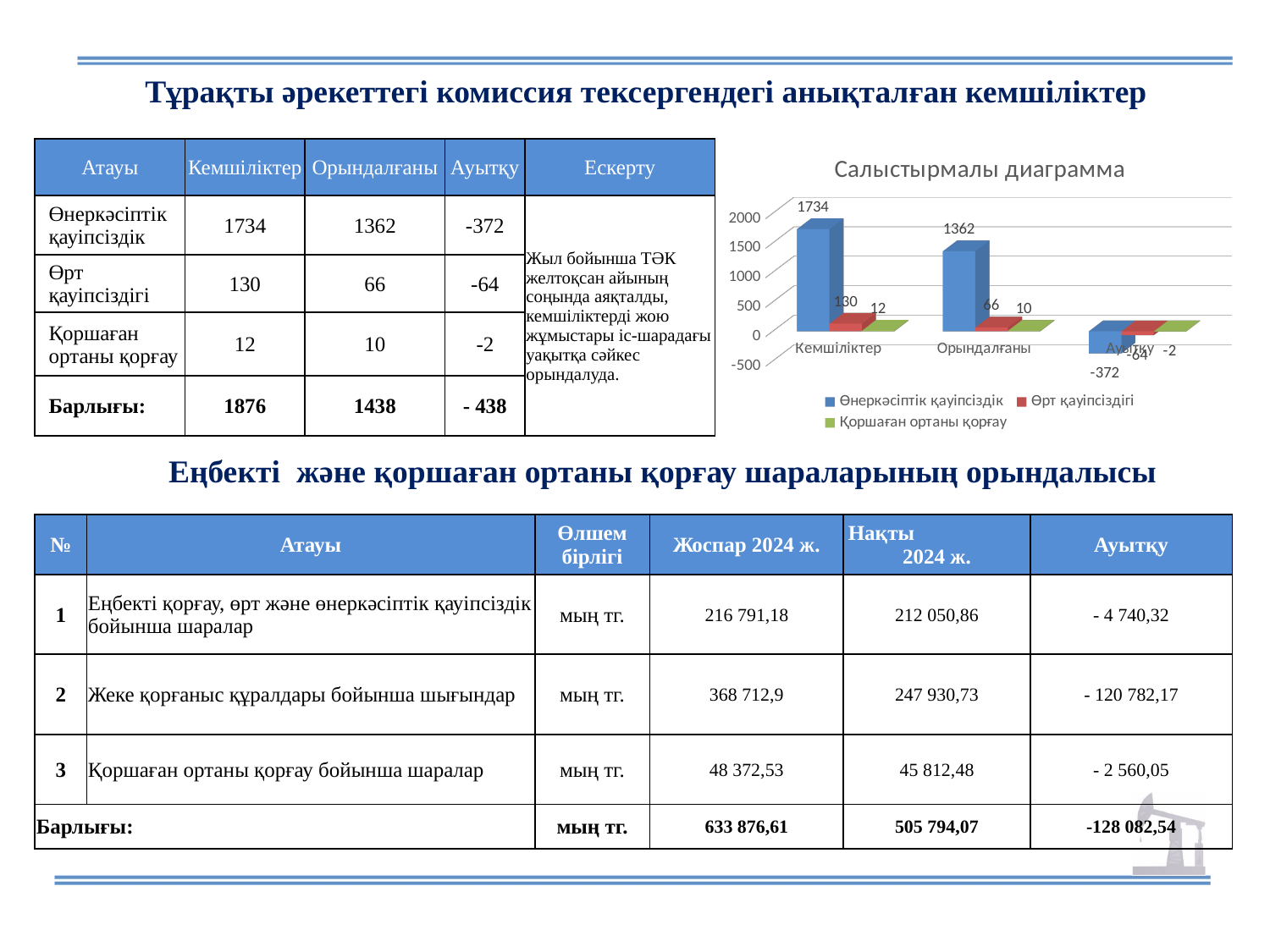
What is the value of Өнеркәсіптік қауіпсіздік for Кемшіліктер in the chart? 1734 How many series does the chart legend list? 3 What kind of chart is shown on the slide? bar chart Which series has the lowest value for Орындалғаны in the chart? Қоршаған ортаны қорғау Is the Өнеркәсіптік қауіпсіздік value for Кемшіліктер greater or less than 1500? greater What is the value of Өнеркәсіптік қауіпсіздік for Орындалғаны in the chart? 1362 What is the difference between the Өнеркәсіптік қауіпсіздік values for Кемшіліктер and Орындалғаны in the chart? 372 How many categories are shown on the x axis of the chart? 3 What is the value of Өнеркәсіптік қауіпсіздік for Ауытқу in the chart? -372 What is the value of Өрт қауіпсіздігі for Орындалғаны in the chart? 66 What is the title of the chart? Салыстырмалы диаграмма Which series has the highest value for Кемшіліктер in the chart? Өнеркәсіптік қауіпсіздік